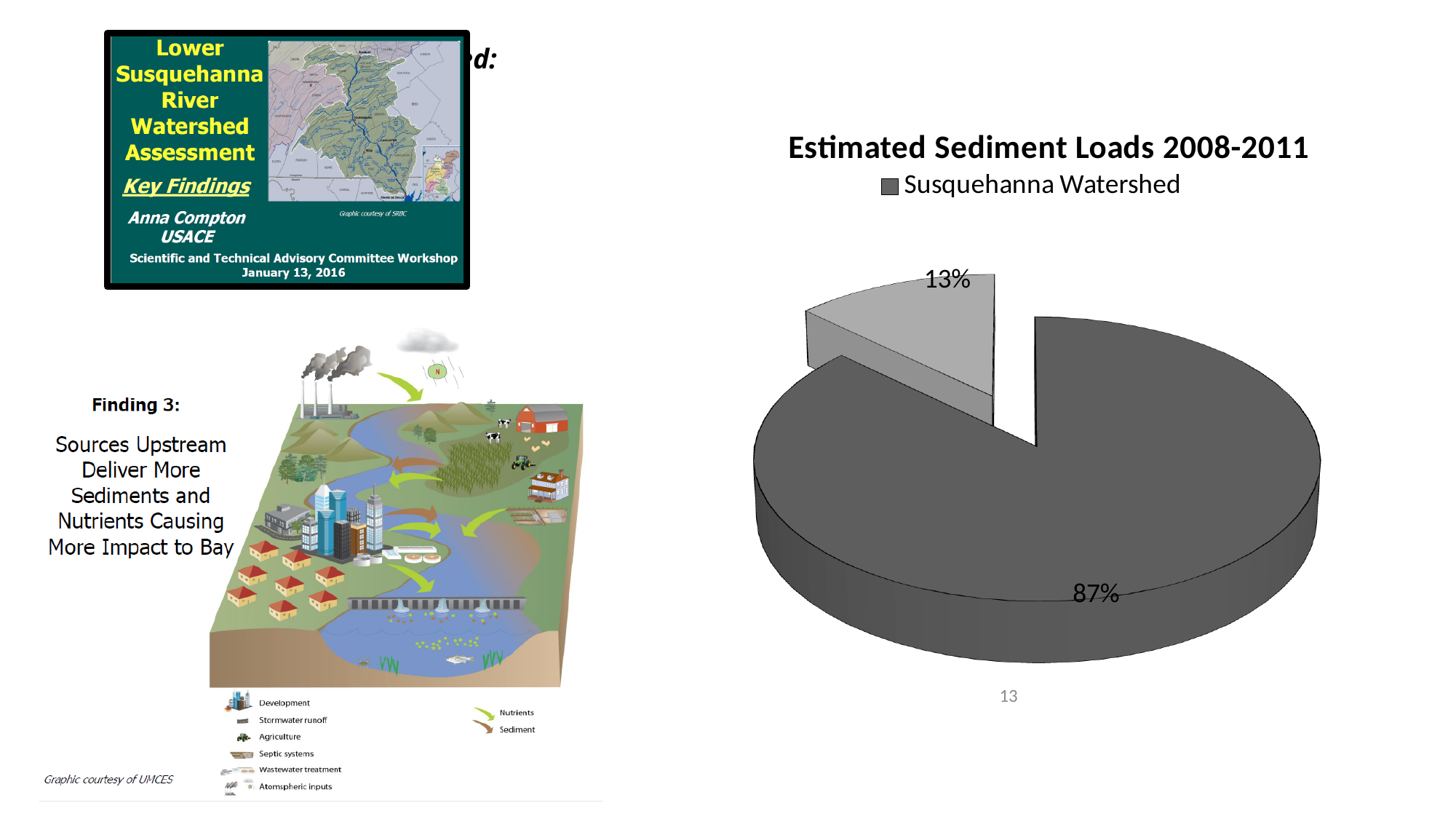
Is the value of the light gray slice in the pie chart greater or less than 20%? less What kind of chart is shown on the right side of the slide? pie chart What is the title of the pie chart? Estimated Sediment Loads 2008-2011 What share of the pie does the dark gray slice represent? 87% What share of the pie does the light gray slice represent? 13% What percentage is shown on the largest slice of the pie chart? 87% Which slice of the pie chart is larger, the dark gray slice or the light gray slice? the dark gray slice What entry does the legend of the pie chart list? Susquehanna Watershed How many slices does the pie chart have? 2 What is the difference in percentage points between the two slices of the pie chart? 74 What percentage is shown on the smallest slice of the pie chart? 13% How many entries does the legend of the pie chart list? 1